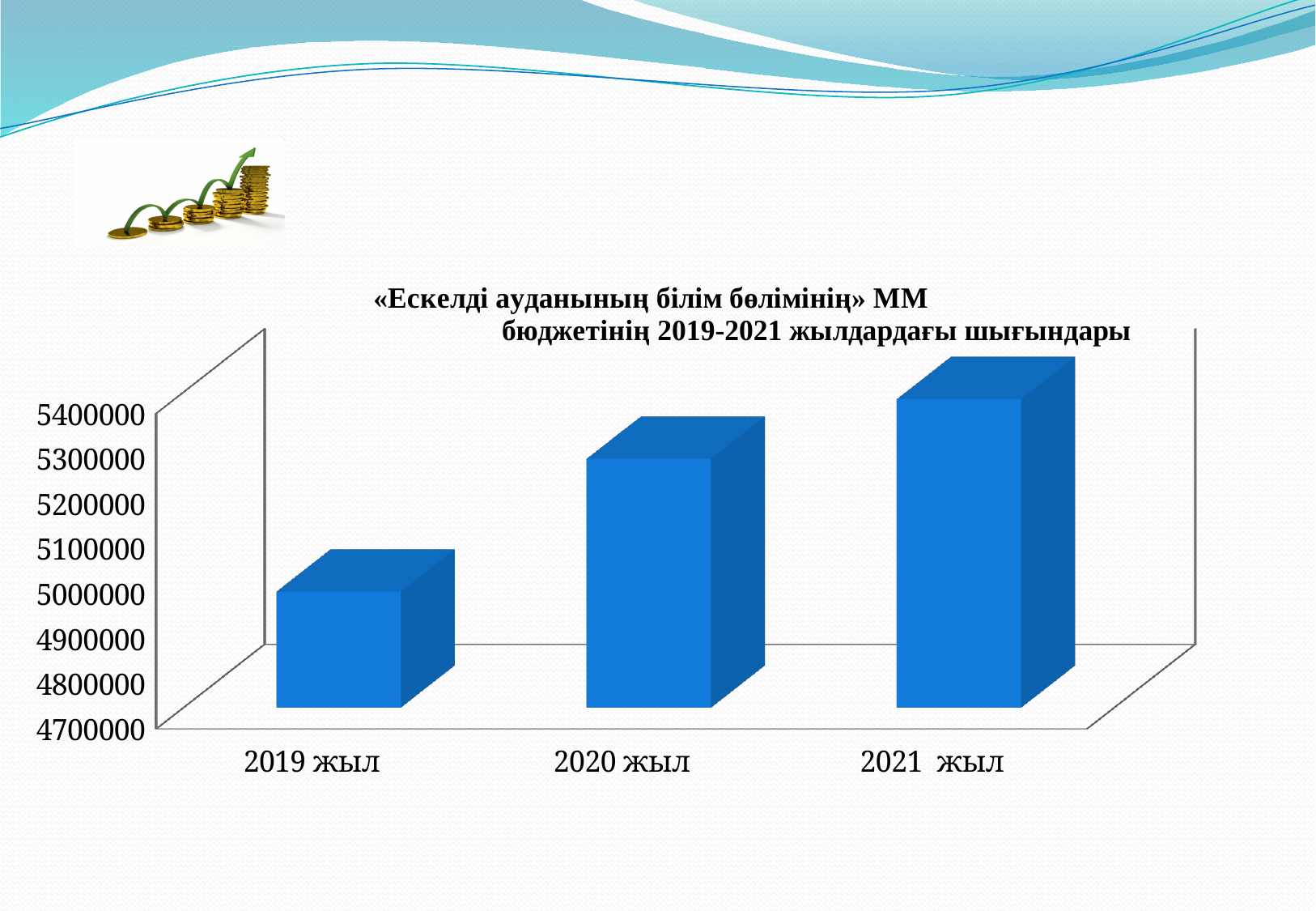
Which is larger, the value for 2020 жыл or the value for 2019 жыл? 2020 жыл What colour are the bars in the chart? blue Which year has the highest bar in the chart? 2021 жыл Is the value for 2019 жыл greater or less than 4900000? greater What is the title of the chart? «Ескелді ауданының білім бөлімінің» ММ бюджетінің 2019-2021 жылдардағы шығындары What kind of chart is shown on the slide? bar chart Is the value for 2019 жыл greater or less than 5200000? less Which year has the lowest bar in the chart? 2019 жыл Is the value for 2020 жыл greater or less than 5100000? greater Do the values rise or fall from 2019 жыл to 2021 жыл? rise How many categories (years) are plotted in the chart? 3